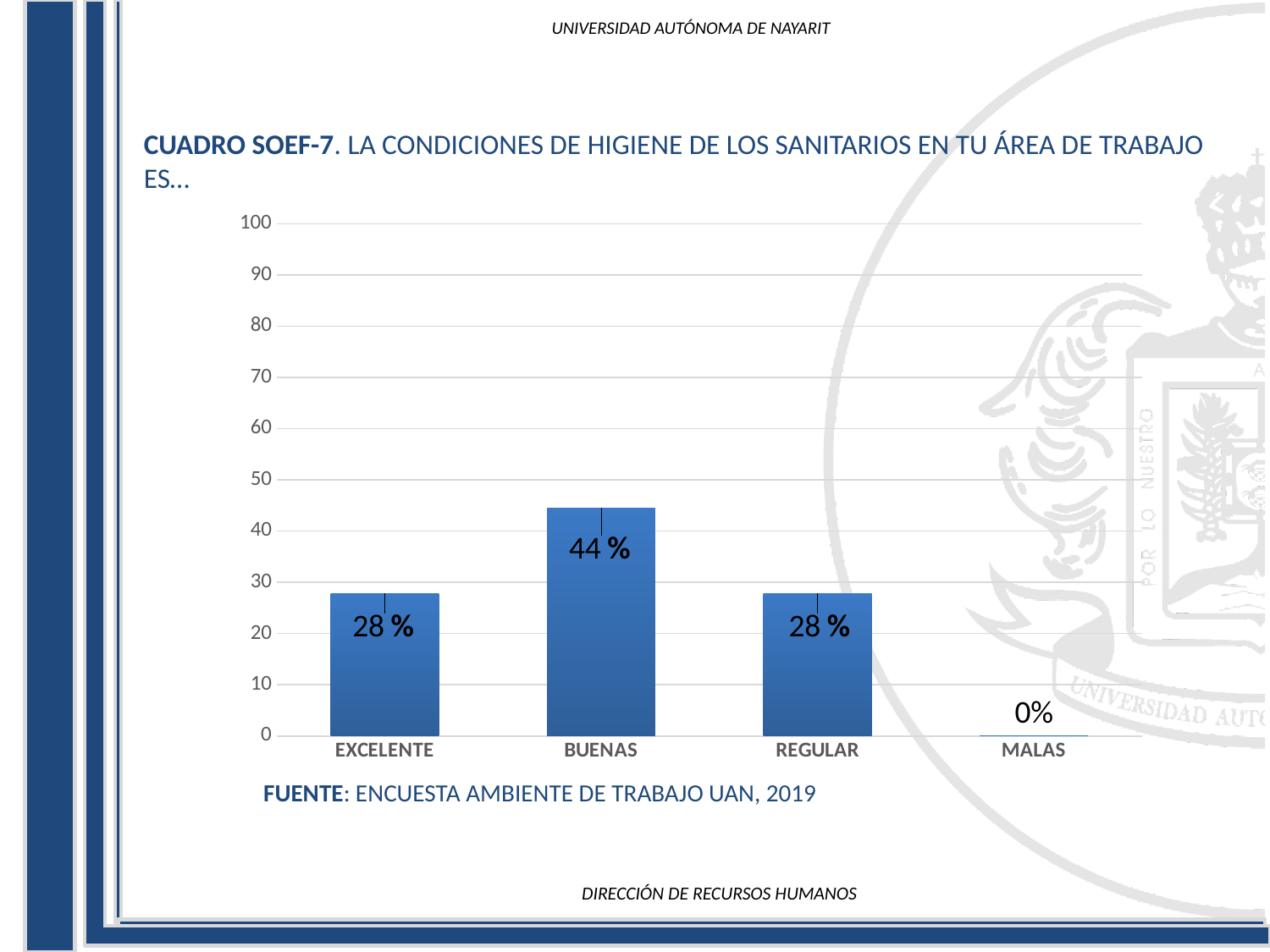
How many categories are shown on the x axis? 4 What is the value for MALAS? 0% What is the value for BUENAS? 44 % What is the value for EXCELENTE? 28 % What is the highest value shown on the y axis? 100 What is the source cited below the chart? ENCUESTA AMBIENTE DE TRABAJO UAN, 2019 Is the value for BUENAS greater or less than 50? less Which category has the highest value? BUENAS What is the difference between the values for BUENAS and REGULAR? 16 % Which category has the lowest value? MALAS What kind of chart is shown on the slide? bar chart Which is larger, the value for BUENAS or the value for EXCELENTE? BUENAS